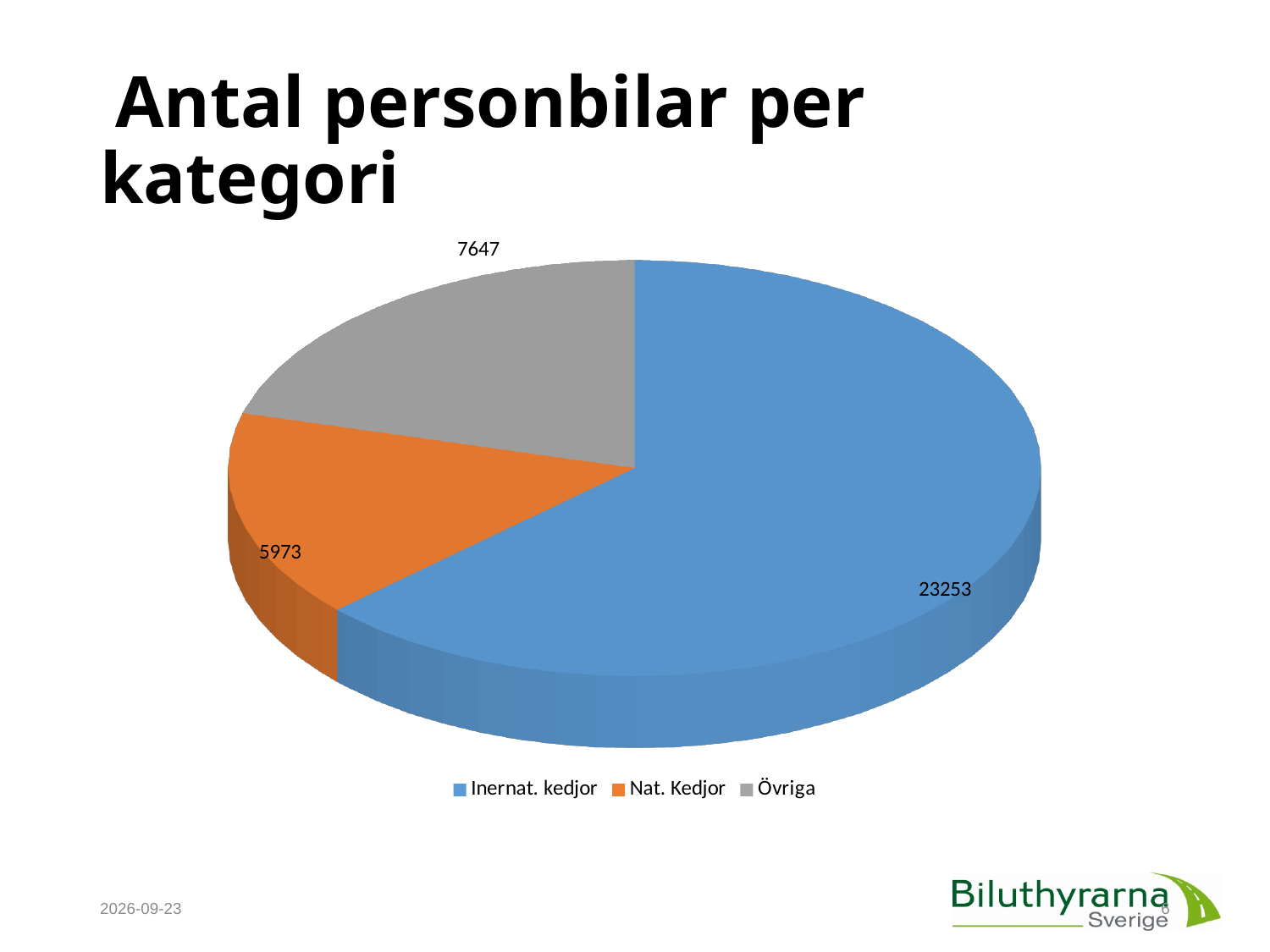
How many categories does the pie chart have? 3 What colour is the slice for Nat. Kedjor? Orange What is the difference between the values for Övriga and Nat. Kedjor? 1674 What is the total of all slices in the pie chart? 36873 What is the value for Övriga? 7647 What is the difference between the values for Inernat. kedjor and Övriga? 15606 Which category has the smallest slice? Nat. Kedjor Which category has the largest slice? Inernat. kedjor Which is larger, the value for Övriga or the value for Nat. Kedjor? Övriga What is the value for Nat. Kedjor? 5973 What is the value for Inernat. kedjor? 23253 What kind of chart is shown on the slide? Pie chart